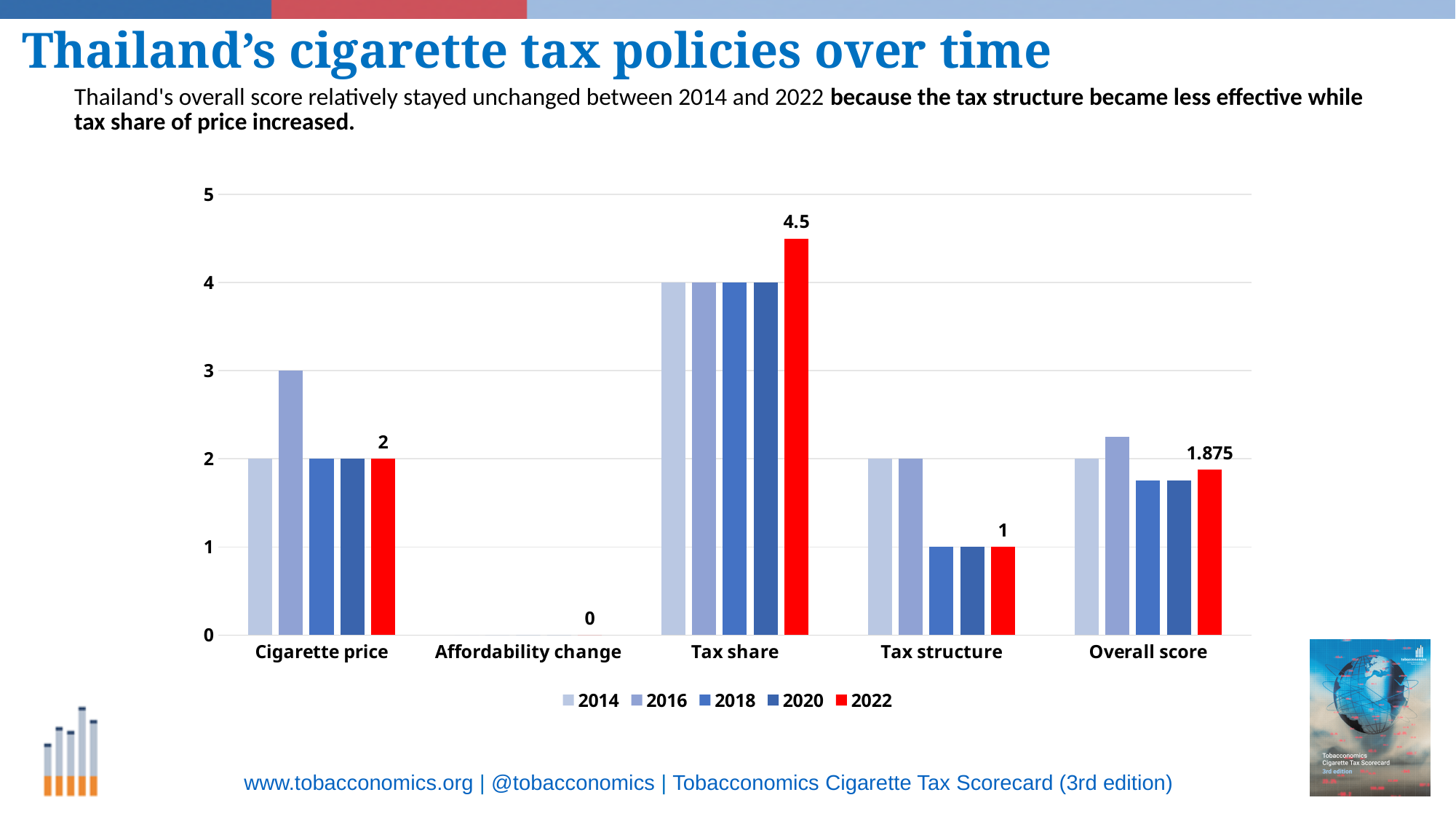
Among the 2022 bars, which category has the highest value? Tax share Do the Tax structure values rise or fall from 2014 to 2022? fall What is the difference between the 2022 values for Tax share and Tax structure? 3.5 What is the value for Affordability change in 2022? 0 How many series does the legend list? 5 In 2022, which is larger: Cigarette price or Tax structure? Cigarette price Is the Overall score for 2016 greater or less than 2? greater What is the value for Cigarette price in 2016? 3 How many categories are shown on the x axis? 5 What is the Overall score for 2022? 1.875 What is the value for Tax share in 2022? 4.5 What kind of chart is shown on the slide? bar chart